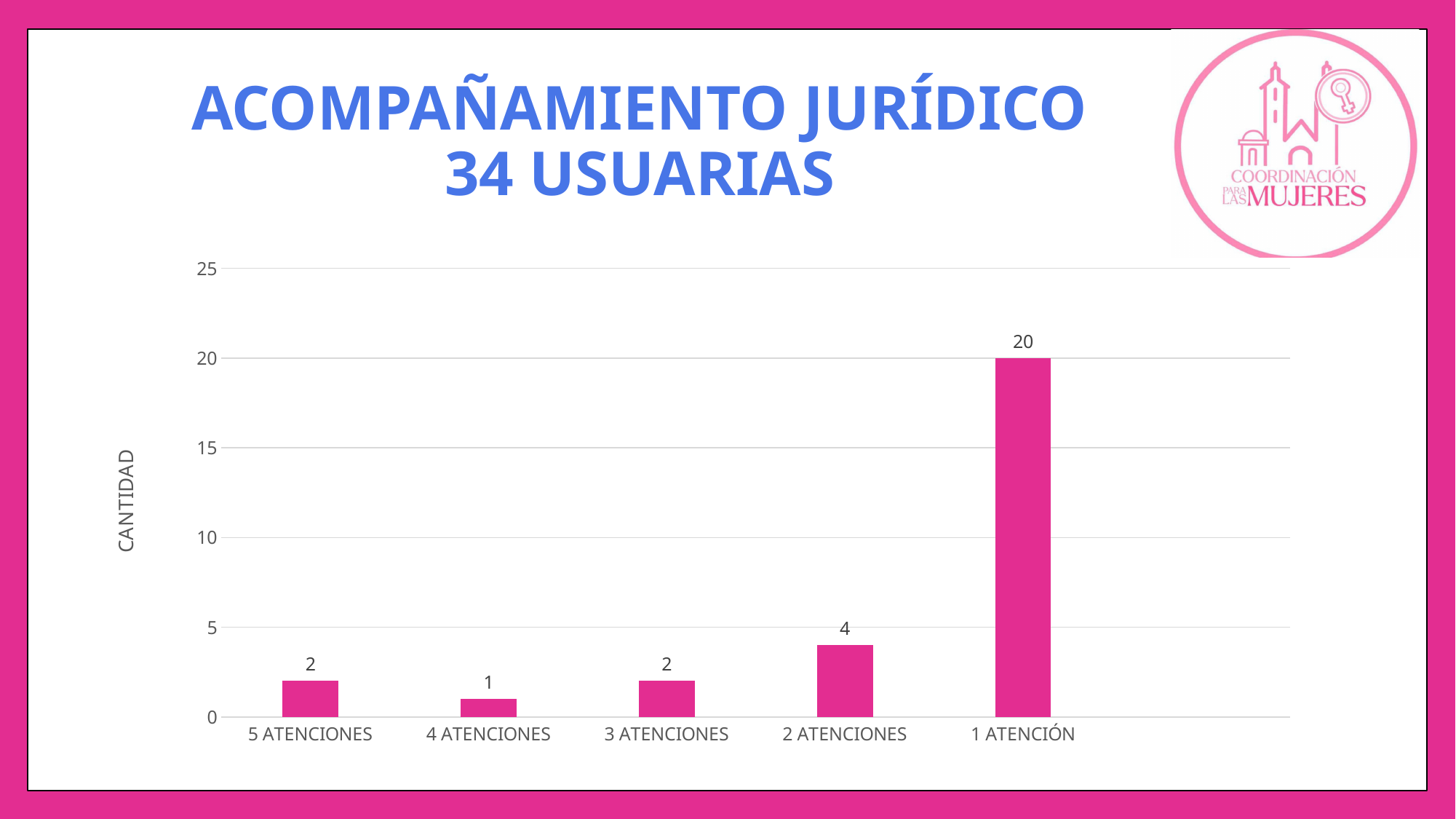
What is the value for 1 ATENCIÓN? 20 Is the value for 1 ATENCIÓN greater or less than 15? greater Which category has the lowest value? 4 ATENCIONES What is the value for 4 ATENCIONES? 1 Which is larger, the value for 2 ATENCIONES or the value for 3 ATENCIONES? 2 ATENCIONES How many categories are shown on the x axis? 5 What is the value for 2 ATENCIONES? 4 What kind of chart is shown on the slide? bar chart What is the value for 5 ATENCIONES? 2 What is the label of the vertical axis? CANTIDAD Which category has the highest value? 1 ATENCIÓN What is the difference between the values for 1 ATENCIÓN and 2 ATENCIONES? 16